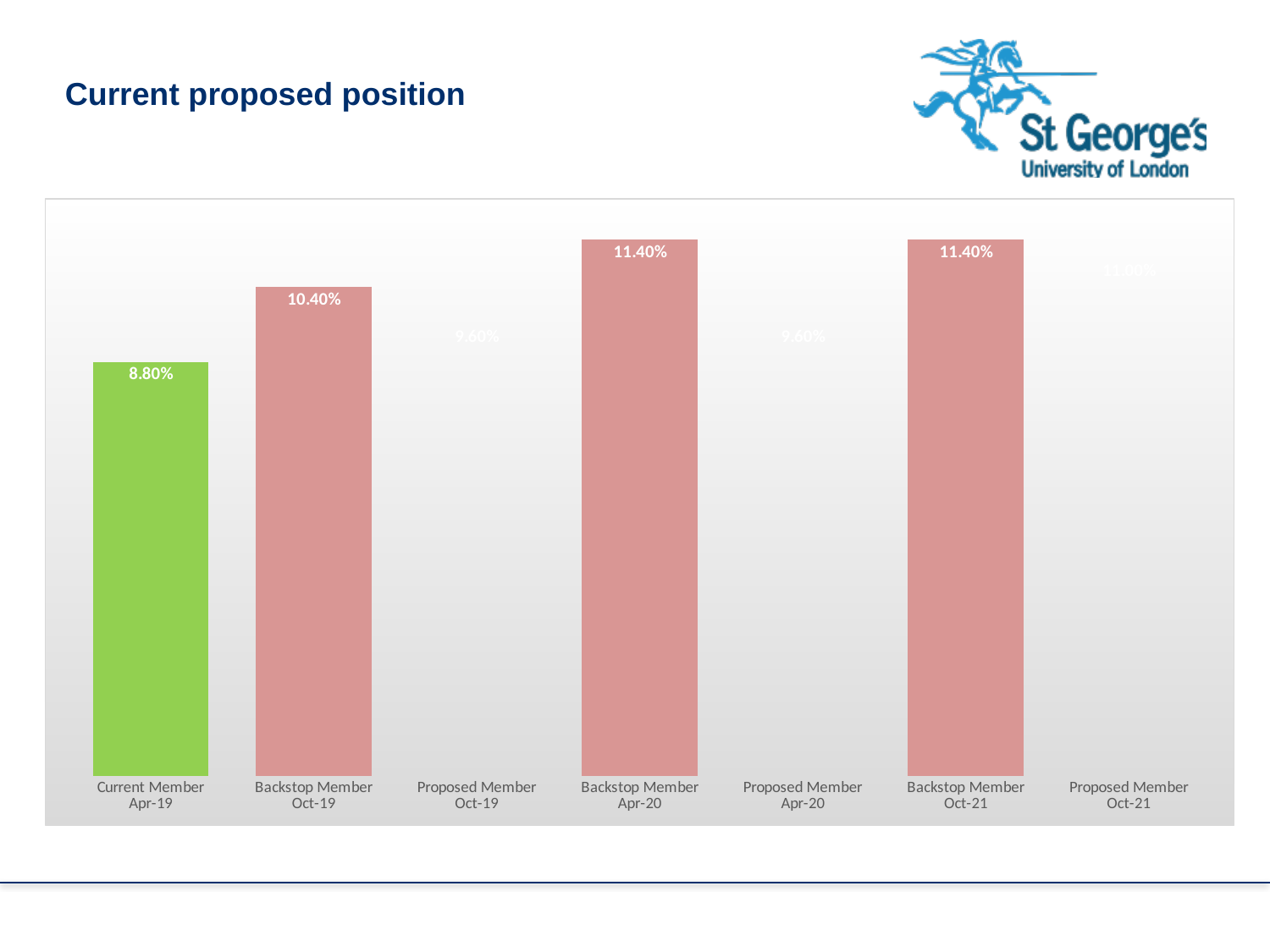
How many categories are shown on the x axis? 7 What is the value for Backstop Member Oct-19? 10.40% What colour is the bar for Current Member Apr-19? Green What kind of chart is shown on the slide? Bar chart What is the value for Backstop Member Apr-20? 11.40% What is the difference between Backstop Member Apr-20 and Backstop Member Oct-19? 1.00% Which category has the lowest value? Current Member Apr-19 What is the value for Current Member Apr-19? 8.80% What is the difference between Backstop Member Oct-19 and Current Member Apr-19? 1.60% Which is larger, Backstop Member Oct-19 or Current Member Apr-19? Backstop Member Oct-19 What is the value for Backstop Member Oct-21? 11.40% Which is larger, Backstop Member Apr-20 or Backstop Member Oct-19? Backstop Member Apr-20